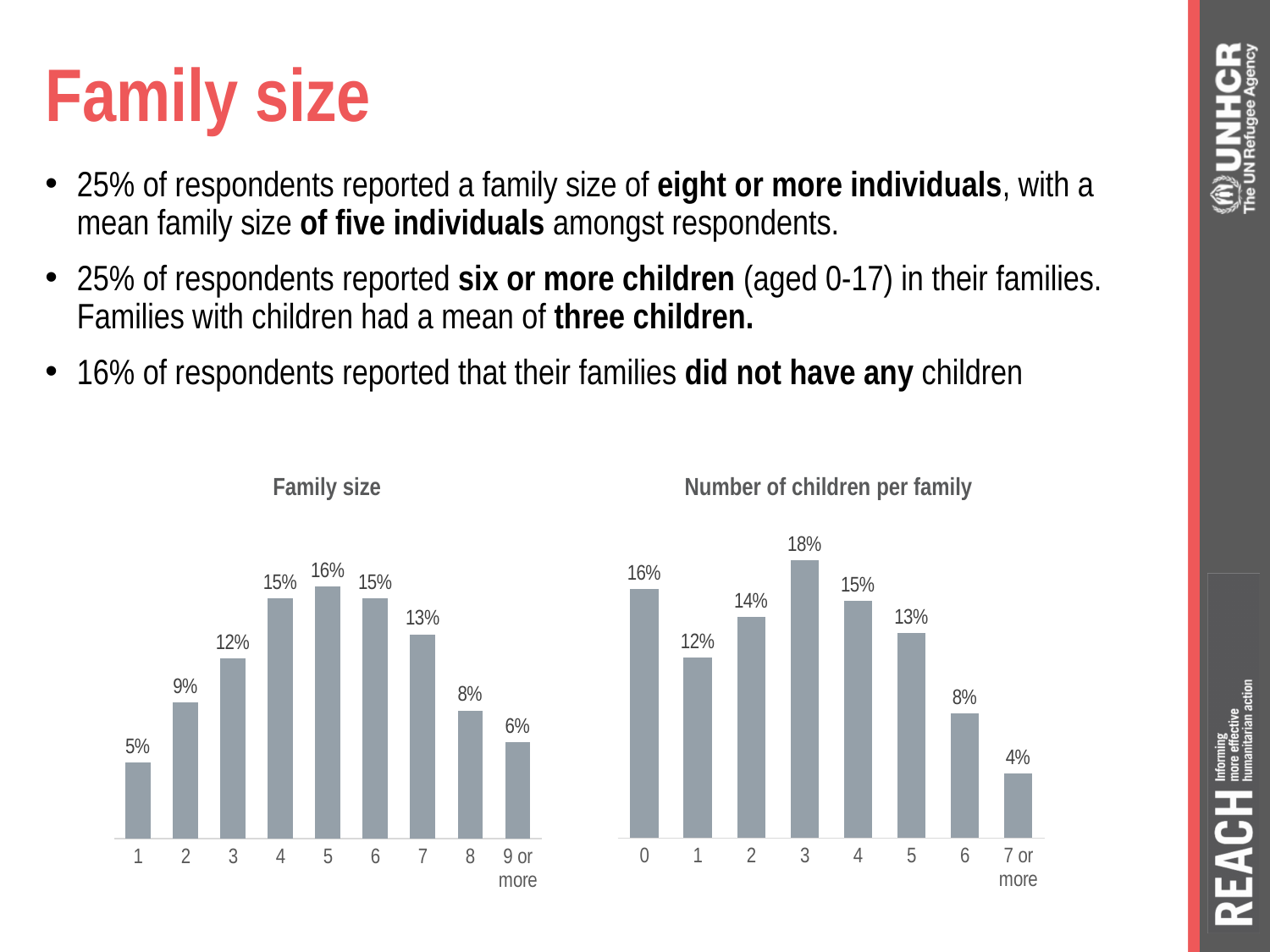
In the 'Number of children per family' chart, what percentage of respondents reported 0 children? 16% In the 'Family size' chart, what percentage of respondents reported a family size of 5? 16% In the 'Family size' chart, what percentage of respondents reported a family size of 9 or more? 6% In the 'Number of children per family' chart, which is larger: the percentage for 1 child or for 5 children? 5 children What type of chart is the 'Number of children per family' chart? Bar chart In the 'Number of children per family' chart, what percentage of respondents reported 3 children? 18% In the 'Family size' chart, which family size has the lowest percentage? 1 In the 'Family size' chart, which family size has the highest percentage? 5 In the 'Number of children per family' chart, what is the difference between the percentages for 3 children and 6 children? 10% In the 'Number of children per family' chart, which category has the lowest percentage? 7 or more In the 'Family size' chart, what is the difference between the percentages for family sizes 3 and 8? 4% In the 'Family size' chart, how many family size categories are shown on the x axis? 9